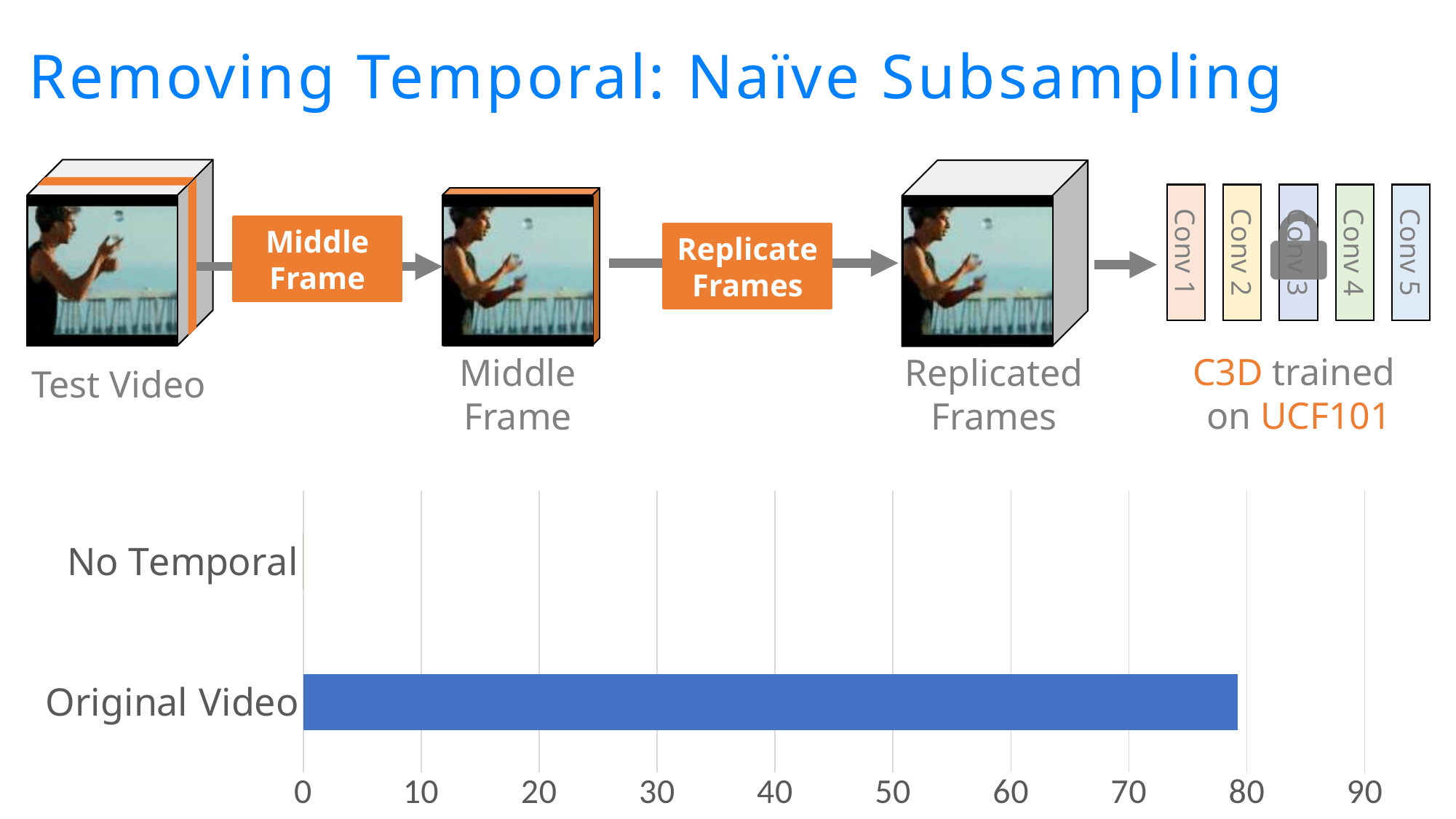
What is the interval between consecutive tick marks on the horizontal axis of the bar chart? 10 Which category in the bar chart has a visible bar plotted? Original Video Is the value for Original Video greater or less than 70? greater What kind of chart is shown at the bottom of the slide? bar chart Is the value for Original Video greater or less than 90? less What is the highest tick value shown on the horizontal axis of the bar chart? 90 Is the value for Original Video greater or less than 50? greater What is the label of the top category on the vertical axis of the bar chart? No Temporal How many categories are listed on the vertical axis of the bar chart? 2